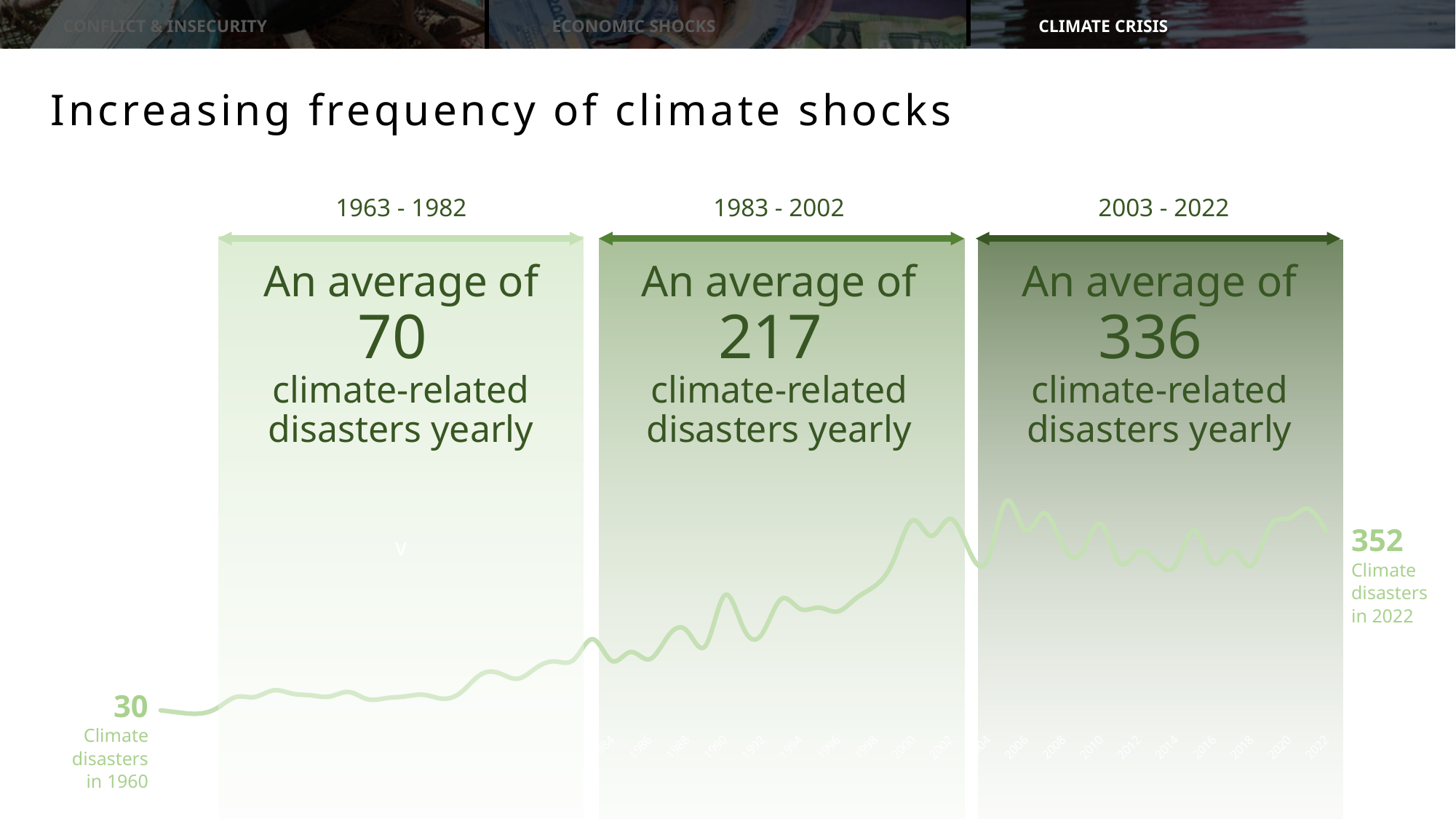
Do the number of climate disasters generally rise or fall from 1960 to 2022? Rise Which period has the lowest average number of climate-related disasters yearly? 1963 - 1982 What is the difference between the yearly average for 2003 - 2022 and the yearly average for 1963 - 1982? 266 Which period has a higher yearly average of climate-related disasters, 1963 - 1982 or 1983 - 2002? 1983 - 2002 How many climate disasters were there in 1960 according to the chart? 30 What was the average number of climate-related disasters yearly in the period 1963 - 1982? 70 By how much did the number of climate disasters in 2022 exceed the number in 1960? 322 How many climate disasters were there in 2022 according to the chart? 352 What was the average number of climate-related disasters yearly in the period 1983 - 2002? 217 Which period has the highest average number of climate-related disasters yearly? 2003 - 2022 What kind of chart is used to show climate disasters over time on this slide? Line chart What was the average number of climate-related disasters yearly in the period 2003 - 2022? 336